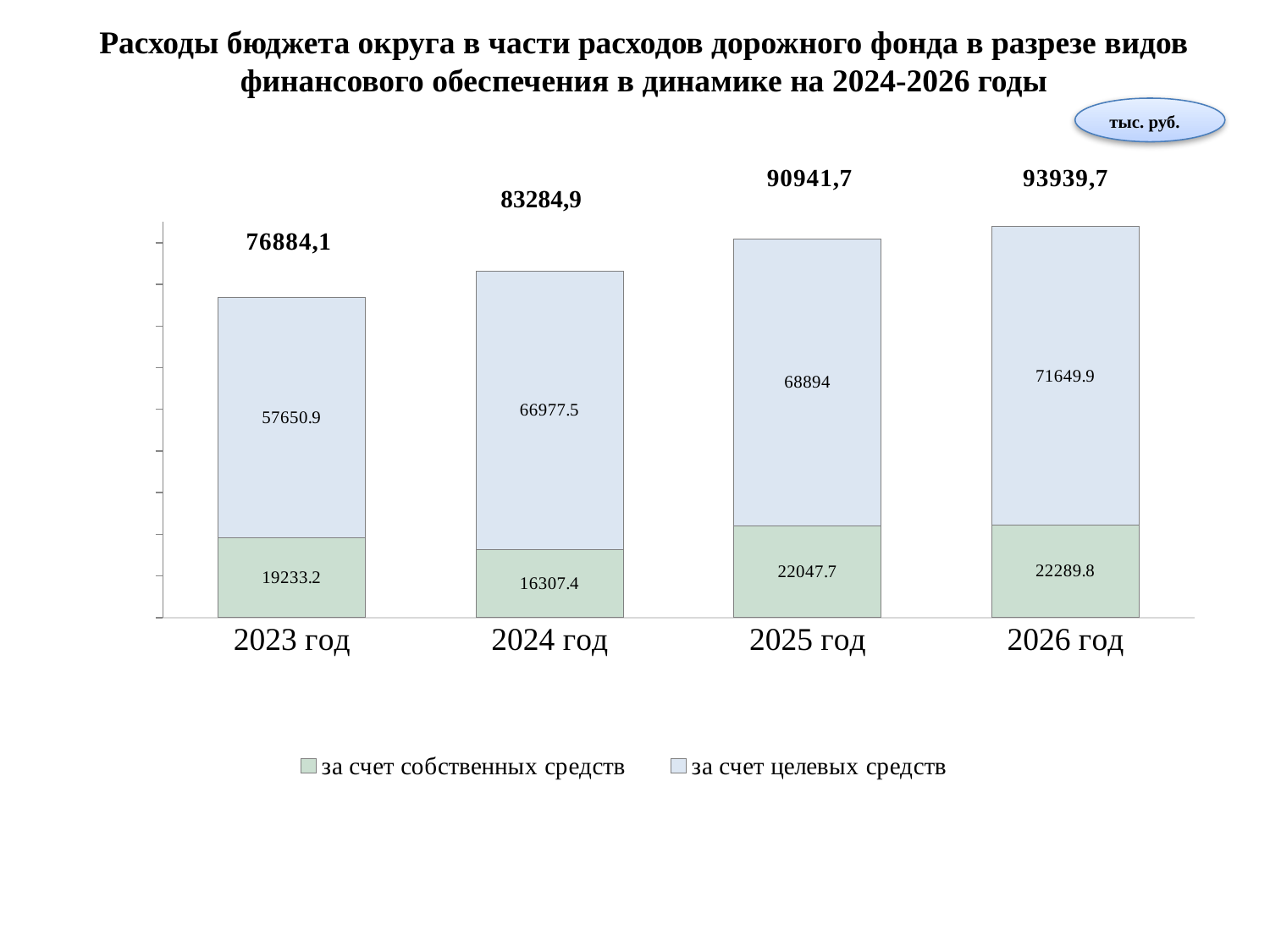
What is the value for 'за счет собственных средств' in 2026 год? 22289.8 What is the difference between the 'за счет целевых средств' values for 2026 год and 2025 год? 2755.9 Which is larger: 'за счет собственных средств' in 2023 год or in 2024 год? 2023 год What is the value for 'за счет целевых средств' in 2025 год? 68894 How many series does the legend list? 2 What is the value for 'за счет собственных средств' in 2023 год? 19233.2 How many years are shown on the x axis? 4 In which year is the value for 'за счет собственных средств' the lowest? 2024 год In which year is the value for 'за счет целевых средств' the highest? 2026 год What is the total value of the stacked bar for 2024 год? 83284,9 Do the total values of the bars rise or fall from 2023 год to 2026 год? Rise What kind of chart is shown on the slide? Stacked bar chart